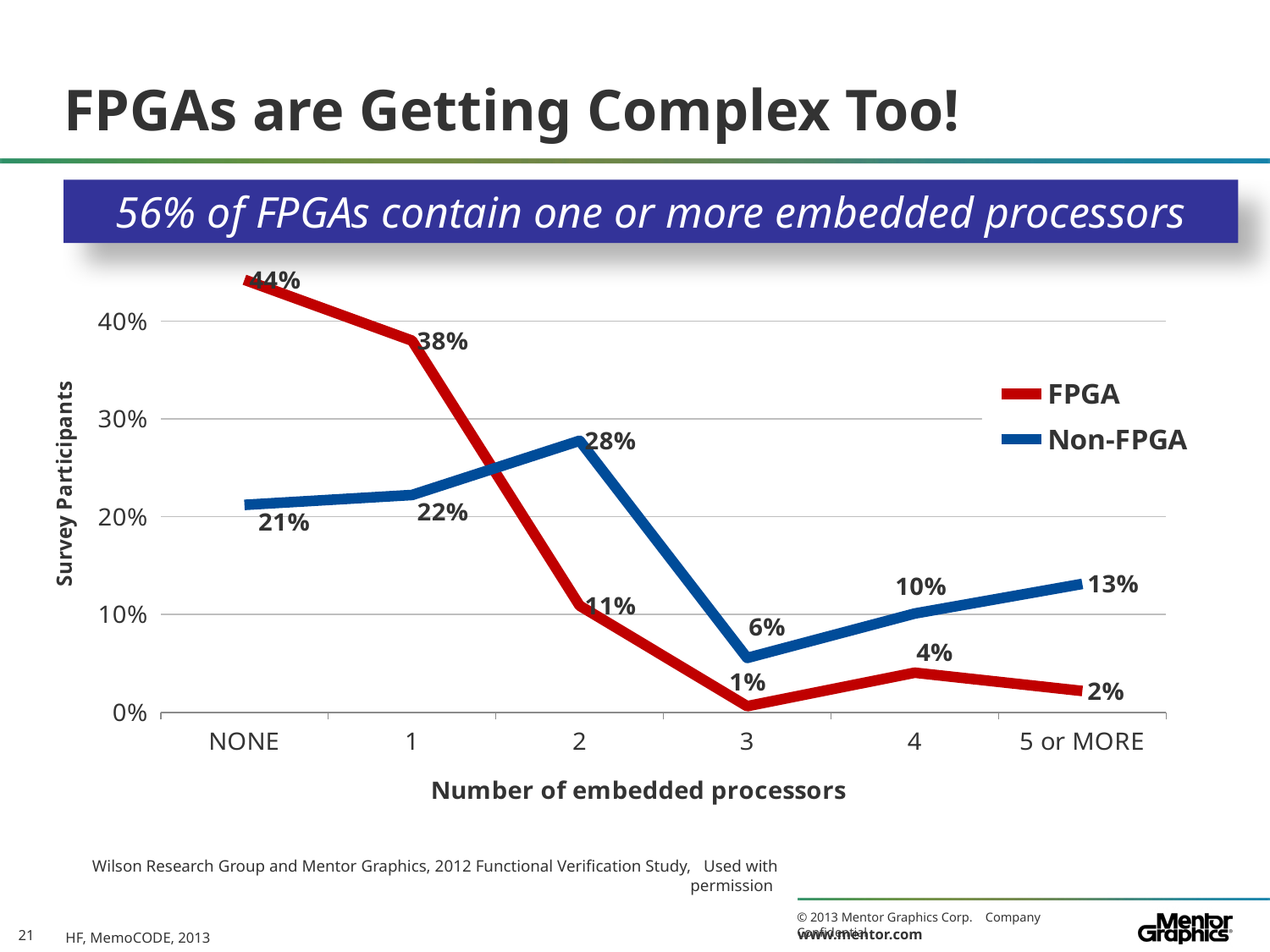
Which category has the lowest FPGA value? 3 What is the label of the y axis? Survey Participants Which category has the highest Non-FPGA value? 2 What is the Non-FPGA value for 5 or MORE embedded processors? 13% What is the Non-FPGA value for 2 embedded processors? 28% What is the difference between the FPGA and Non-FPGA values for 1 embedded processor? 16% For 4 embedded processors, which series has the larger value, FPGA or Non-FPGA? Non-FPGA What kind of chart is shown on the slide? line chart What is the FPGA value for 3 embedded processors? 1% What is the FPGA value for NONE embedded processors? 44% How many series does the legend list? 2 How many categories are shown on the x axis? 6